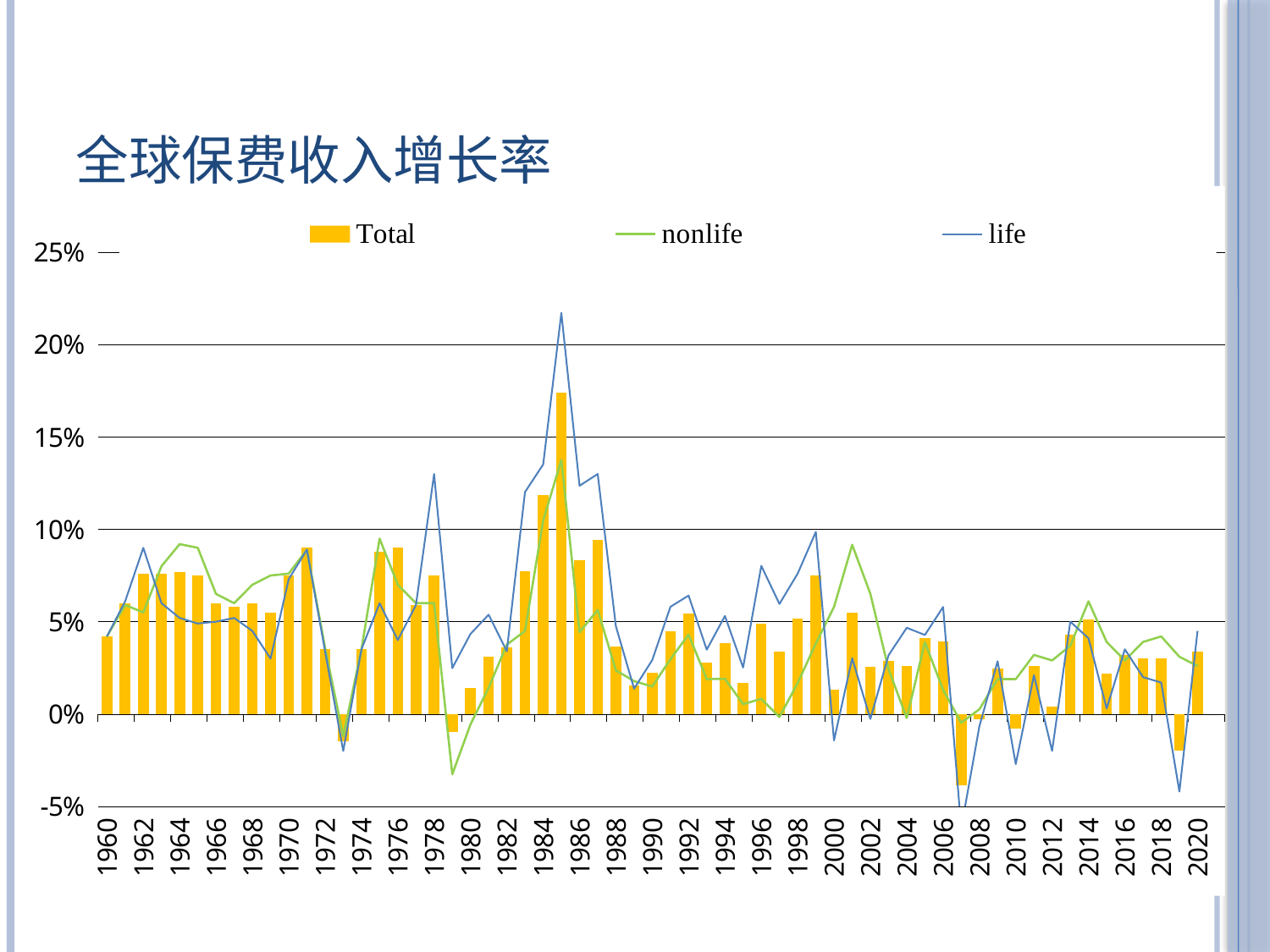
What are the three series named in the legend? Total, nonlife, life In which year is the Total growth rate highest? 1985 How many series does the legend list? 3 Which is larger, the Total value for 1985 or for 1986? 1985 Is the Total value for 1985 greater or less than 15%? greater In which year is the Total growth rate lowest? 2007 Which series is plotted as bars rather than a line? Total Is the life value for 1985 greater or less than 20%? greater In 1985, which series is higher, life or nonlife? life What kind of chart is shown on the slide? A combined bar and line chart Is the Total value for 2007 greater or less than 0%? less